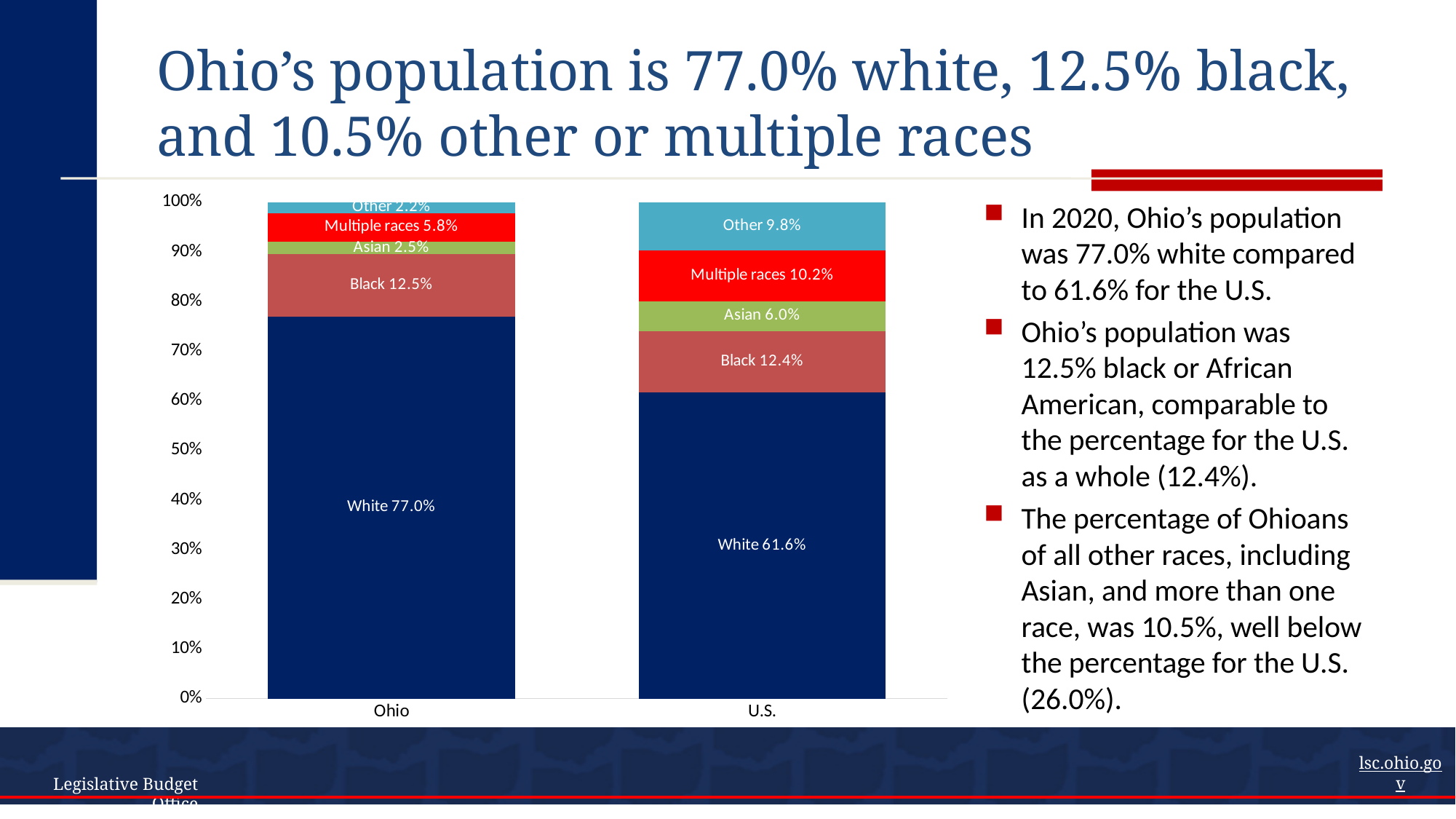
How many bars (categories) are shown on the x axis of the chart? 2 Which race group is the largest segment in the U.S. bar? White What type of chart is shown on the slide? Stacked bar chart What is the difference between the U.S. and Ohio Asian percentages? 3.5 percentage points By how many percentage points does Ohio's White share exceed the U.S. White share? 15.4 percentage points Which has the larger Multiple races percentage, Ohio or the U.S.? U.S. What is the Other percentage for the U.S. bar? 9.8% Which race group is the smallest segment in the Ohio bar? Other What percentage of Ohio's population is White according to the chart? 77.0% What is the Multiple races percentage for Ohio? 5.8% What is the Black share of the U.S. population shown in the chart? 12.4% What is the Asian percentage for the U.S. bar? 6.0%